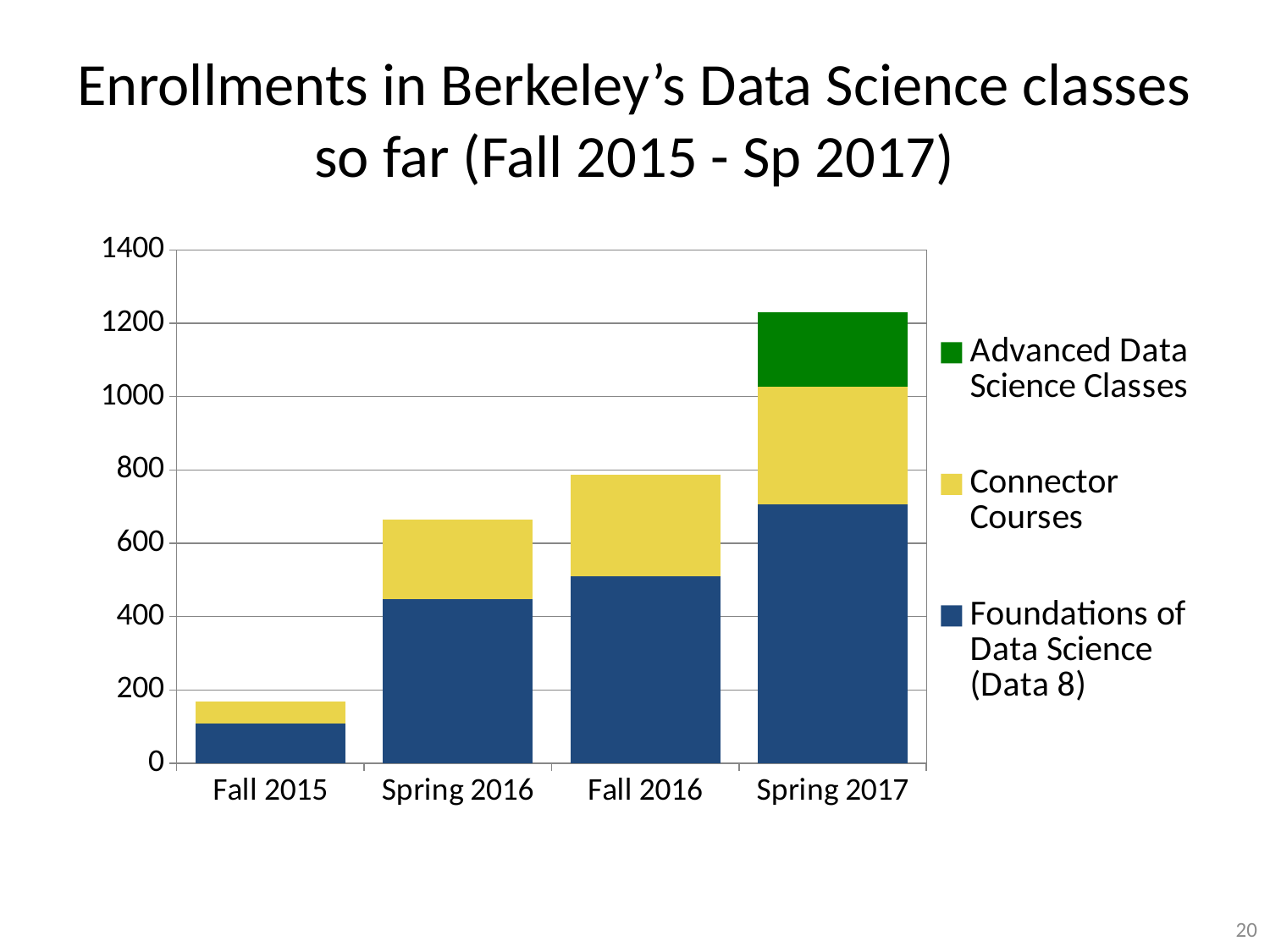
Is the total enrollment for Spring 2017 greater or less than 1000? greater Which semester has the highest total enrollment? Spring 2017 Is the total enrollment for Fall 2015 greater or less than 200? less Is the total enrollment for Spring 2016 greater or less than 600? greater Which semester has the lowest total enrollment? Fall 2015 Do total enrollments rise or fall from Fall 2015 to Spring 2017? rise How many series does the legend list? 3 How many semesters (categories) are shown on the x axis? 4 Which semester is the only one with Advanced Data Science Classes enrollment shown? Spring 2017 Which is larger, the total enrollment in Fall 2016 or in Spring 2016? Fall 2016 What kind of chart is shown on the slide? stacked bar chart